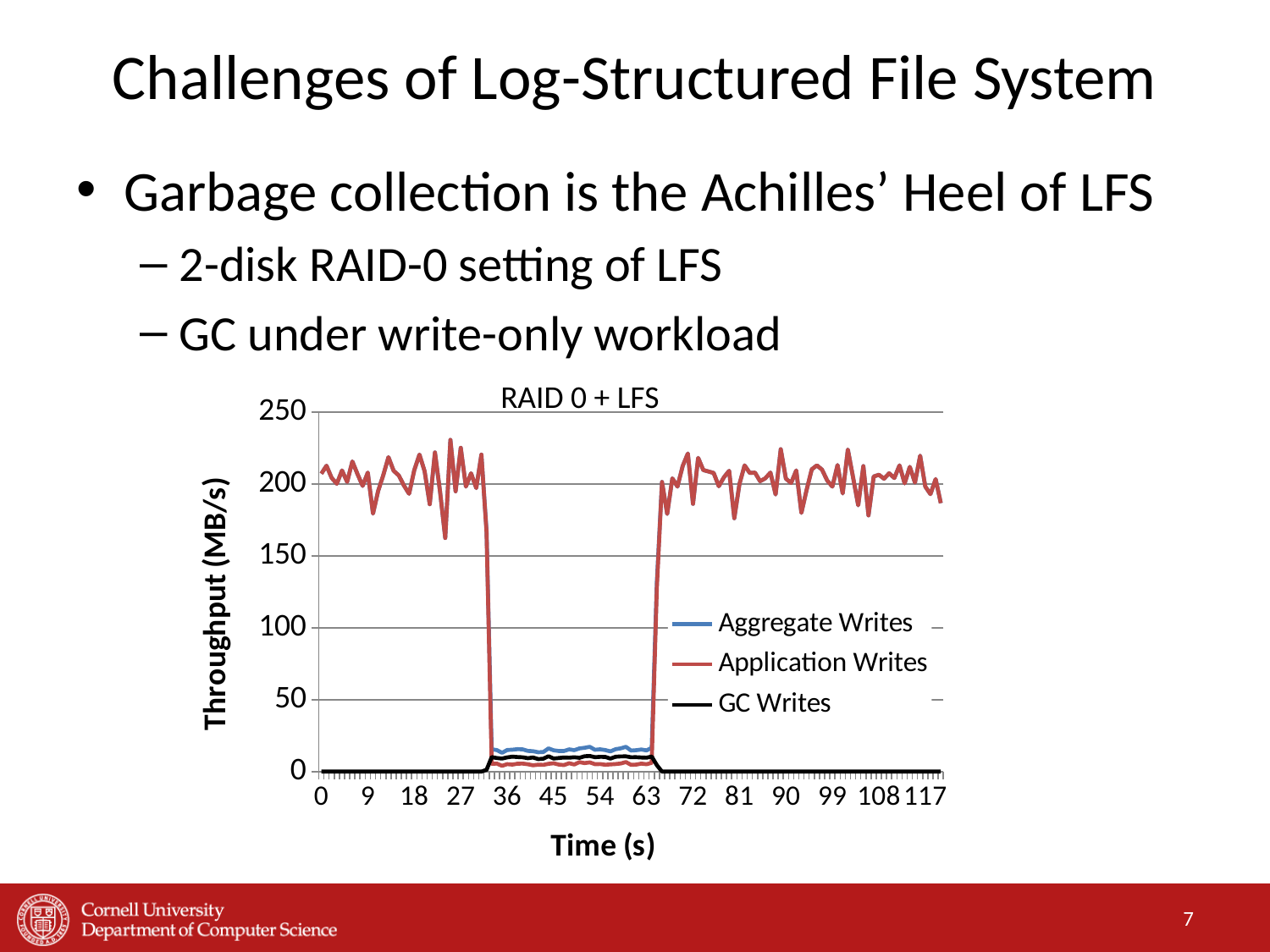
Which is larger at time 9: Application Writes or GC Writes? Application Writes Is the value for GC Writes at time 90 greater or less than 50? less Is the value for Application Writes at time 9 greater or less than 150? greater How many series does the chart's legend list? 3 Is the value for Aggregate Writes at time 99 greater or less than 150? greater What kind of chart is shown on the slide? line chart What is the title of the chart? RAID 0 + LFS Which is larger at time 45: Application Writes or Aggregate Writes? Aggregate Writes Does the Application Writes series rise or fall between time 27 and time 36? fall What is the label of the y axis? Throughput (MB/s)